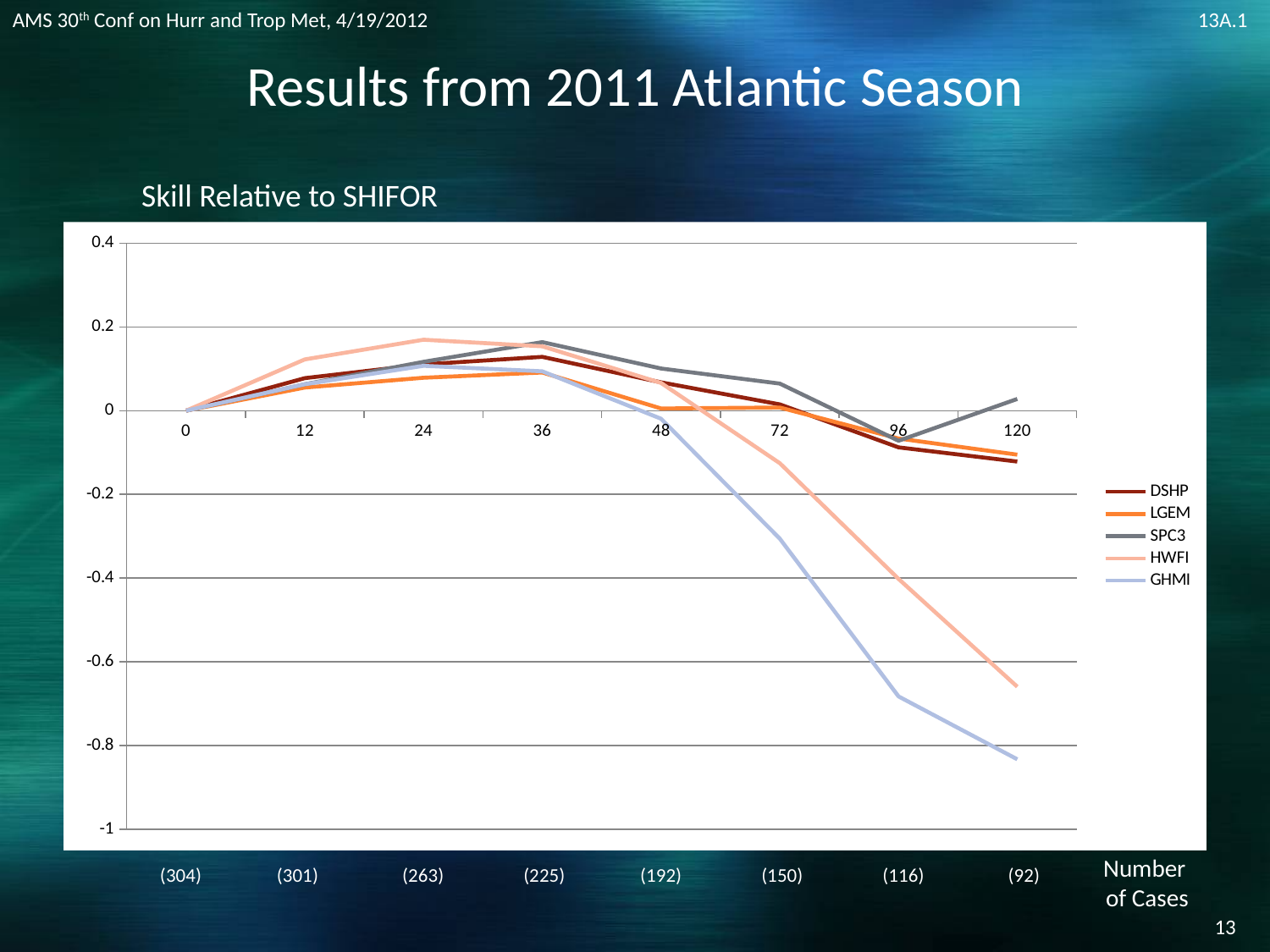
What kind of chart is shown on the slide? line chart Does the GHMI line rise or fall from forecast hour 48 to forecast hour 120? fall Is the value for HWFI at forecast hour 72 greater or less than 0? less Is the value for DSHP at forecast hour 36 greater or less than 0? greater At forecast hour 120, which is larger, the value for HWFI or the value for GHMI? HWFI How many series does the legend list? 5 Is the value for GHMI at forecast hour 120 greater or less than -0.6? less Which series has the highest value at forecast hour 120? SPC3 Which series has the highest value at forecast hour 24? HWFI What is the title of the chart? Skill Relative to SHIFOR Which series has the lowest value at forecast hour 120? GHMI How many forecast hour points are labelled along the x axis? 8